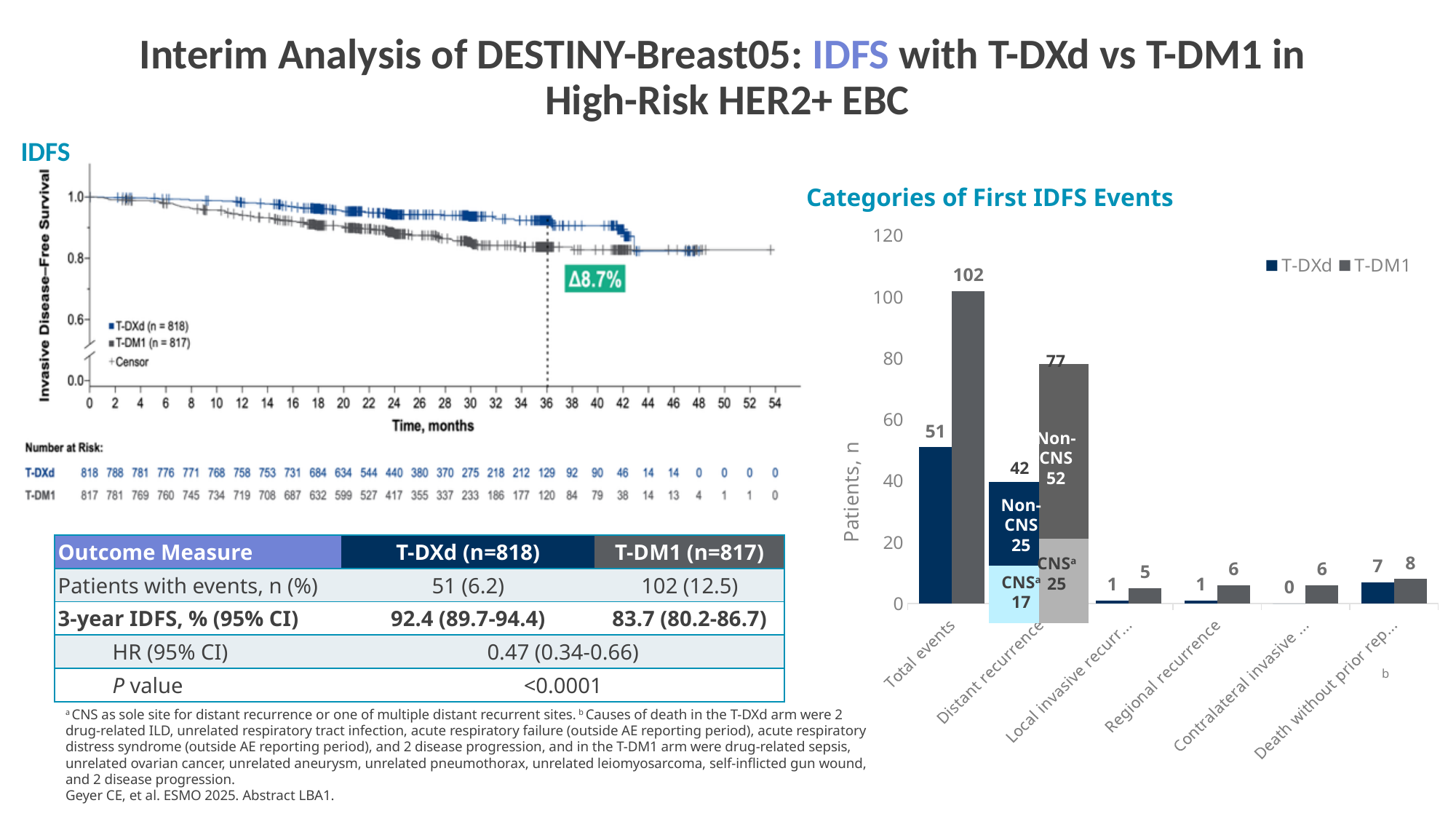
In the 'Categories of First IDFS Events' bar chart, what is the difference between the T-DM1 and T-DXd values for Total events? 51 In the 'Categories of First IDFS Events' bar chart, what is the CNS portion of the T-DXd Distant recurrence bar? 17 In the 'Categories of First IDFS Events' bar chart, what is the value for T-DM1 in the Distant recurrence category? 77 In the 'Categories of First IDFS Events' bar chart, what is the value for T-DXd in the Total events category? 51 What kind of chart is the 'Categories of First IDFS Events' chart? bar chart How many series does the legend of the 'Categories of First IDFS Events' chart list? 2 In the 'Categories of First IDFS Events' bar chart, what is the value for T-DM1 in the Total events category? 102 In the 'Categories of First IDFS Events' bar chart, which category has the highest T-DM1 value? Total events In the 'Categories of First IDFS Events' bar chart, what is the value for T-DM1 in the Regional recurrence category? 6 How many categories are shown on the x axis of the 'Categories of First IDFS Events' chart? 6 In the 'Categories of First IDFS Events' bar chart, which series has the larger value for Regional recurrence, T-DXd or T-DM1? T-DM1 In the 'Categories of First IDFS Events' bar chart, what is the total of the T-DM1 Distant recurrence stacked bar (CNS plus Non-CNS)? 77